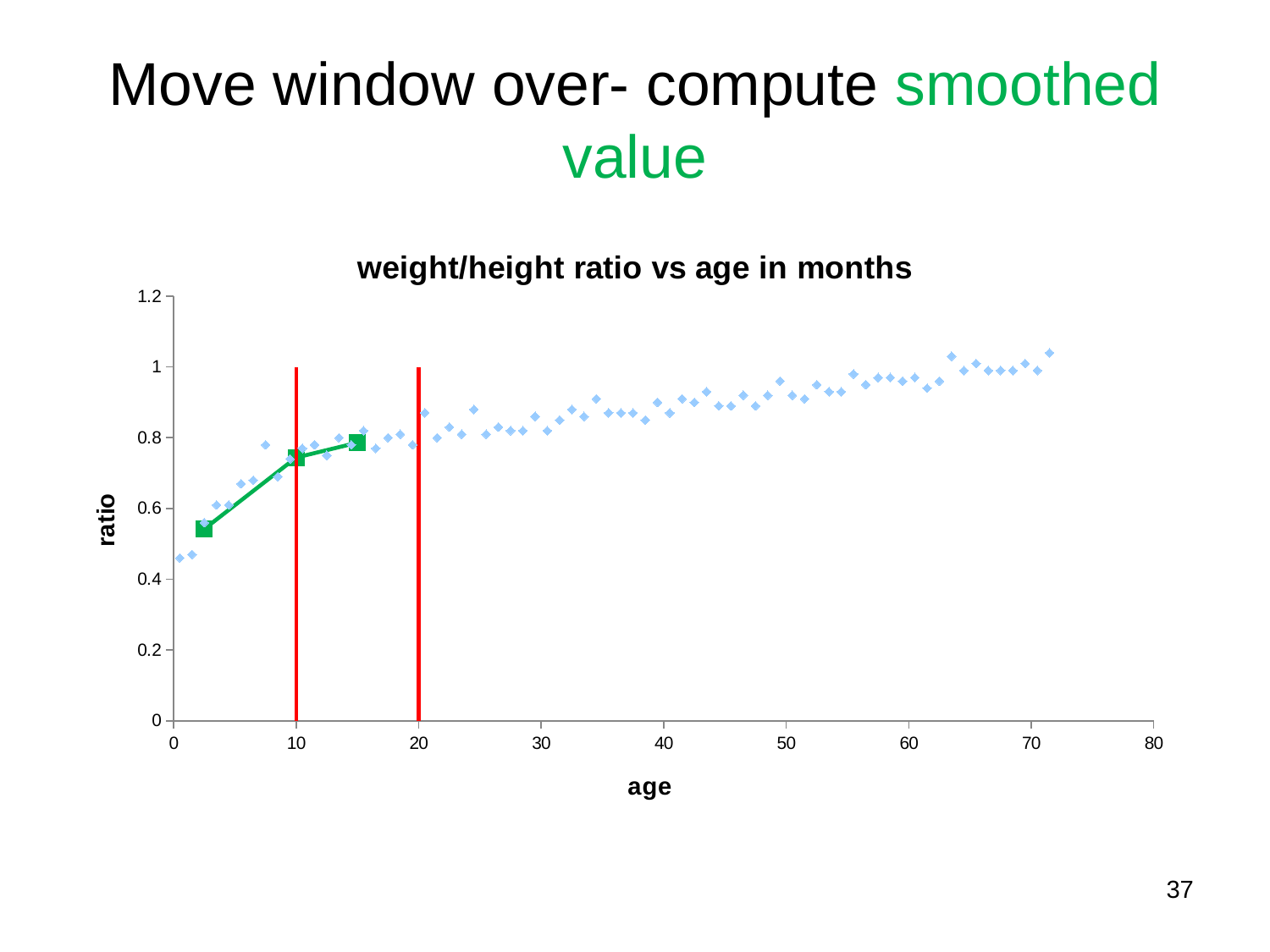
At which two x-axis values are the red vertical lines drawn? 10 and 20 Which is larger, the ratio at age 60 or the ratio at age 5? age 60 Is the ratio value at age 20 greater or less than 0.6? greater Is the ratio value at age 0 greater or less than 0.6? less How many green square markers are on the smoothed line? 3 What is the highest value shown on the y axis? 1.2 What is the label of the x axis? age Is the ratio value at age 40 greater or less than 1? less What kind of chart is shown on the slide? scatter chart What is the title of the chart? weight/height ratio vs age in months Do the plotted ratio values generally rise or fall as age increases? rise